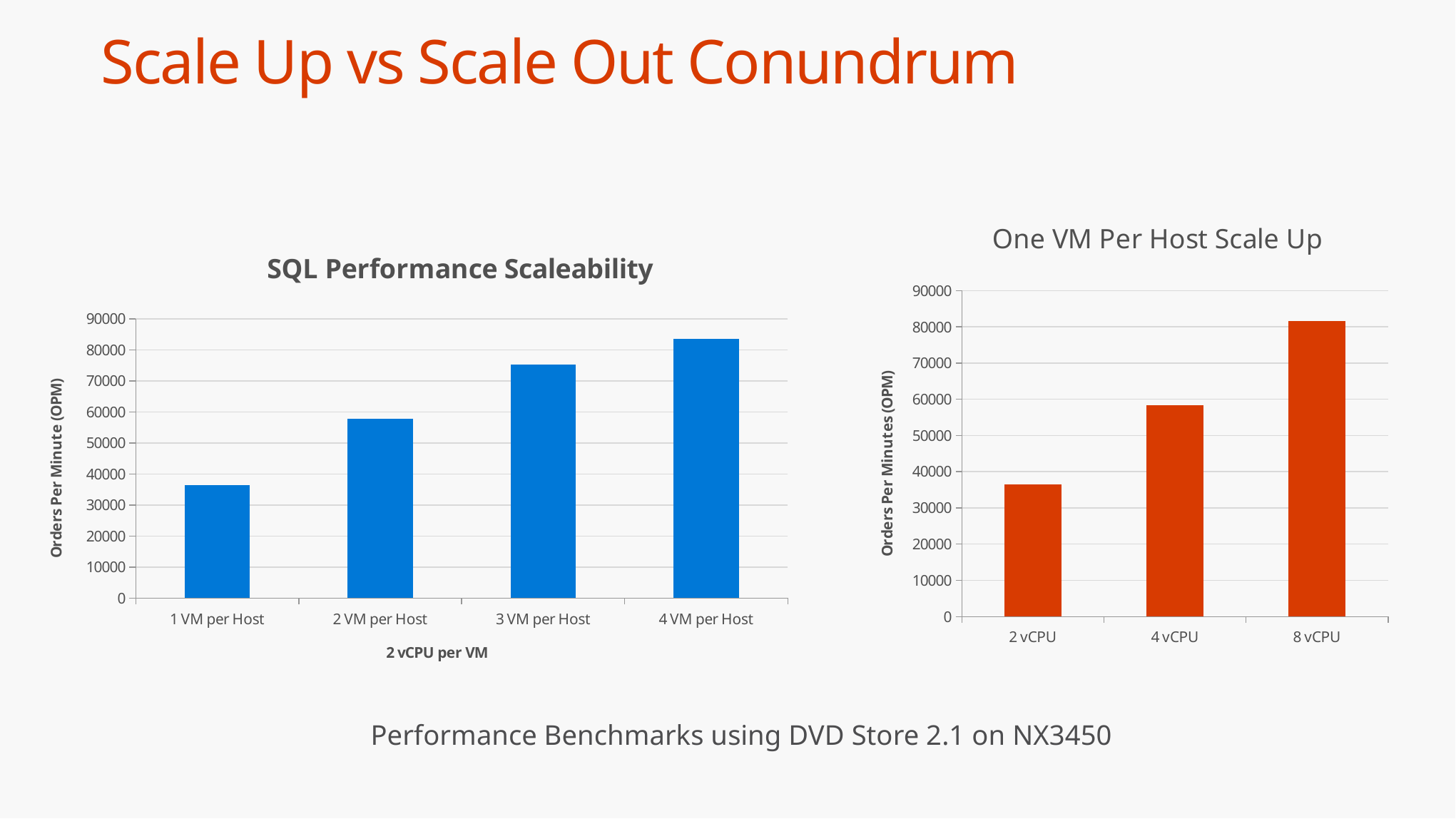
In the 'SQL Performance Scaleability' chart, is the value for 1 VM per Host greater or less than 40000? less In the 'One VM Per Host Scale Up' chart, which is larger, the value for 2 vCPU or the value for 4 vCPU? 4 vCPU What kind of chart is the 'One VM Per Host Scale Up' chart? bar chart In the 'SQL Performance Scaleability' chart, which category has the highest value? 4 VM per Host In the 'One VM Per Host Scale Up' chart, is the value for 4 vCPU greater or less than 50000? greater What is the y-axis label of the 'SQL Performance Scaleability' chart? Orders Per Minute (OPM) In the 'One VM Per Host Scale Up' chart, which category has the highest value? 8 vCPU In the 'SQL Performance Scaleability' chart, is the value for 3 VM per Host greater or less than 70000? greater In the 'SQL Performance Scaleability' chart, which category has the lowest value? 1 VM per Host In the 'SQL Performance Scaleability' chart, do the values rise or fall from 1 VM per Host to 4 VM per Host? rise In the 'SQL Performance Scaleability' chart, how many categories are shown on the x axis? 4